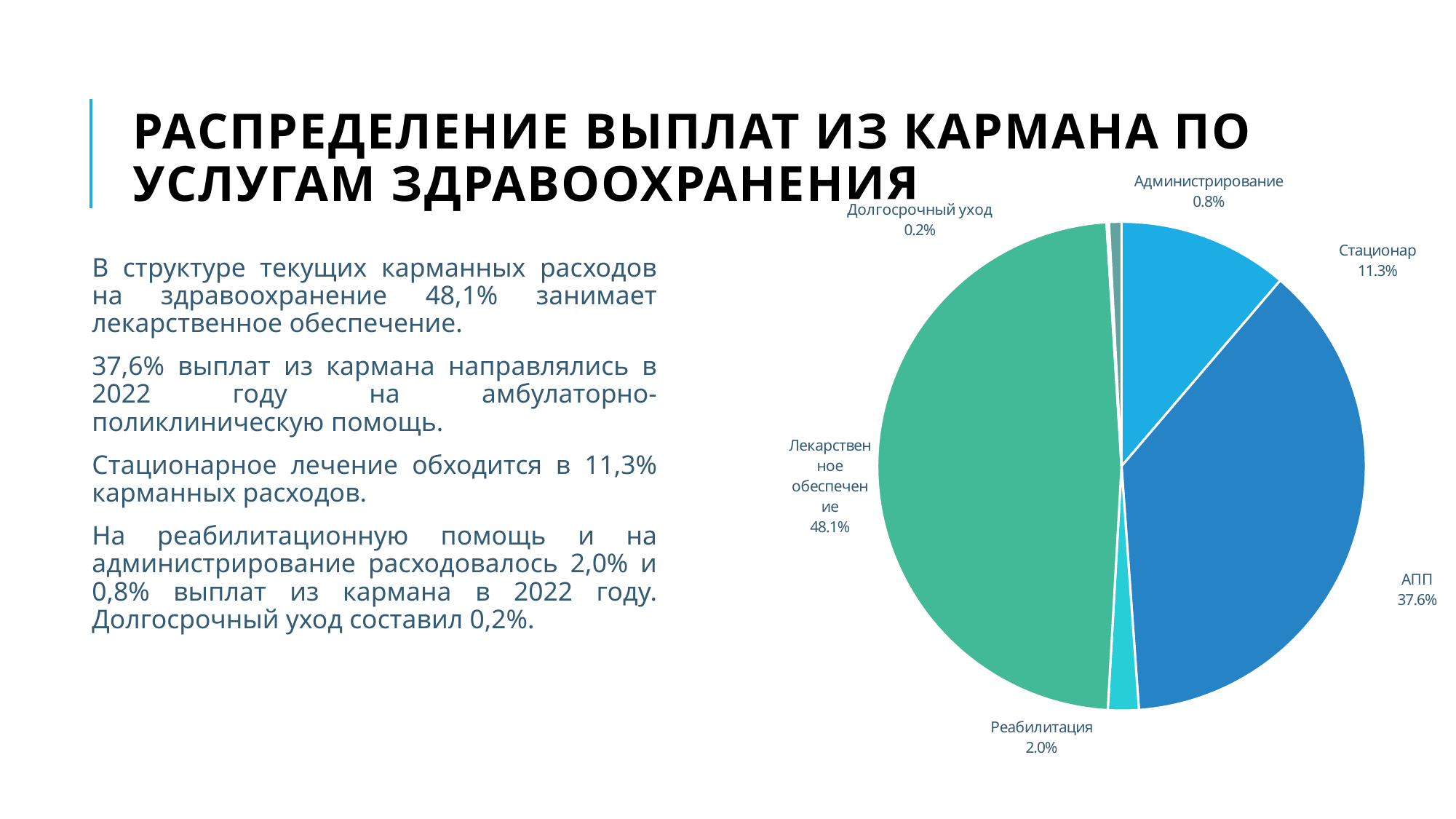
Which category has the smallest slice of the pie? Долгосрочный уход Which is larger, the share for Стационар or the share for Реабилитация? Стационар What is the value for АПП? 37.6% What is the difference between the shares of Лекарственное обеспечение and АПП? 10.5% What share of the pie does Лекарственное обеспечение have? 48.1% How many categories are shown in the pie chart? 6 What is the value for Долгосрочный уход? 0.2% What is the value for Стационар? 11.3% What is the value for Реабилитация? 2.0% Which category has the largest slice of the pie? Лекарственное обеспечение What kind of chart is shown on the slide? pie chart What is the value for Администрирование? 0.8%